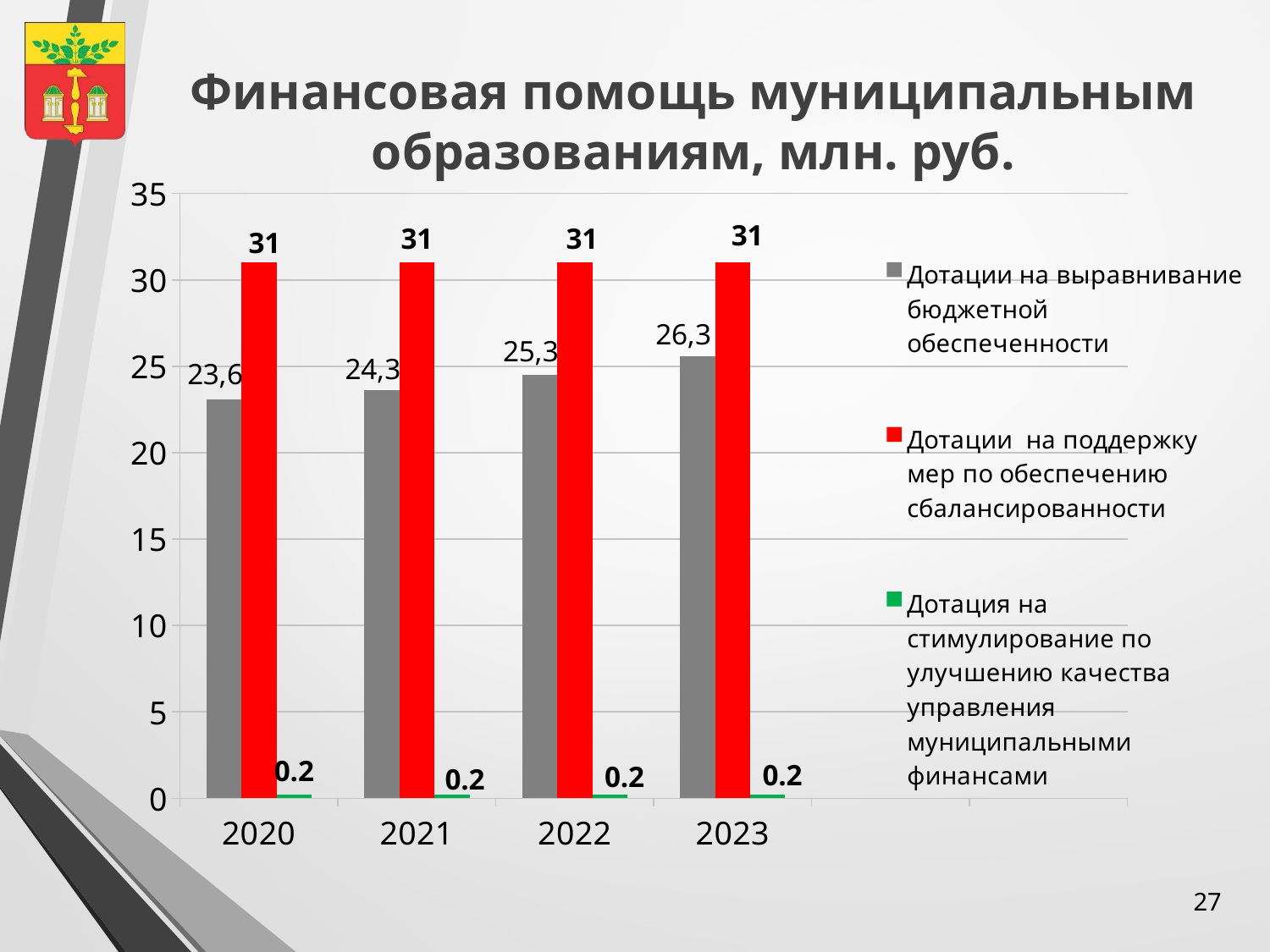
How many series does the legend list? 3 In which year is 'Дотации на выравнивание бюджетной обеспеченности' highest? 2023 What is the value of 'Дотации на выравнивание бюджетной обеспеченности' in 2020? 23,6 In which year is 'Дотации на выравнивание бюджетной обеспеченности' lowest? 2020 What is the value of 'Дотации на выравнивание бюджетной обеспеченности' in 2023? 26,3 What is the value of 'Дотации на поддержку мер по обеспечению сбалансированности' in 2022? 31 Does 'Дотации на выравнивание бюджетной обеспеченности' rise or fall from 2020 to 2023? Rise Which is larger in 2021: 'Дотации на выравнивание бюджетной обеспеченности' or 'Дотации на поддержку мер по обеспечению сбалансированности'? Дотации на поддержку мер по обеспечению сбалансированности How many years are shown on the x axis? 4 What is the difference between the 2023 and 2020 values of 'Дотации на выравнивание бюджетной обеспеченности'? 2,7 What kind of chart is shown on the slide? Bar chart What is the value of 'Дотация на стимулирование по улучшению качества управления муниципальными финансами' in 2021? 0.2